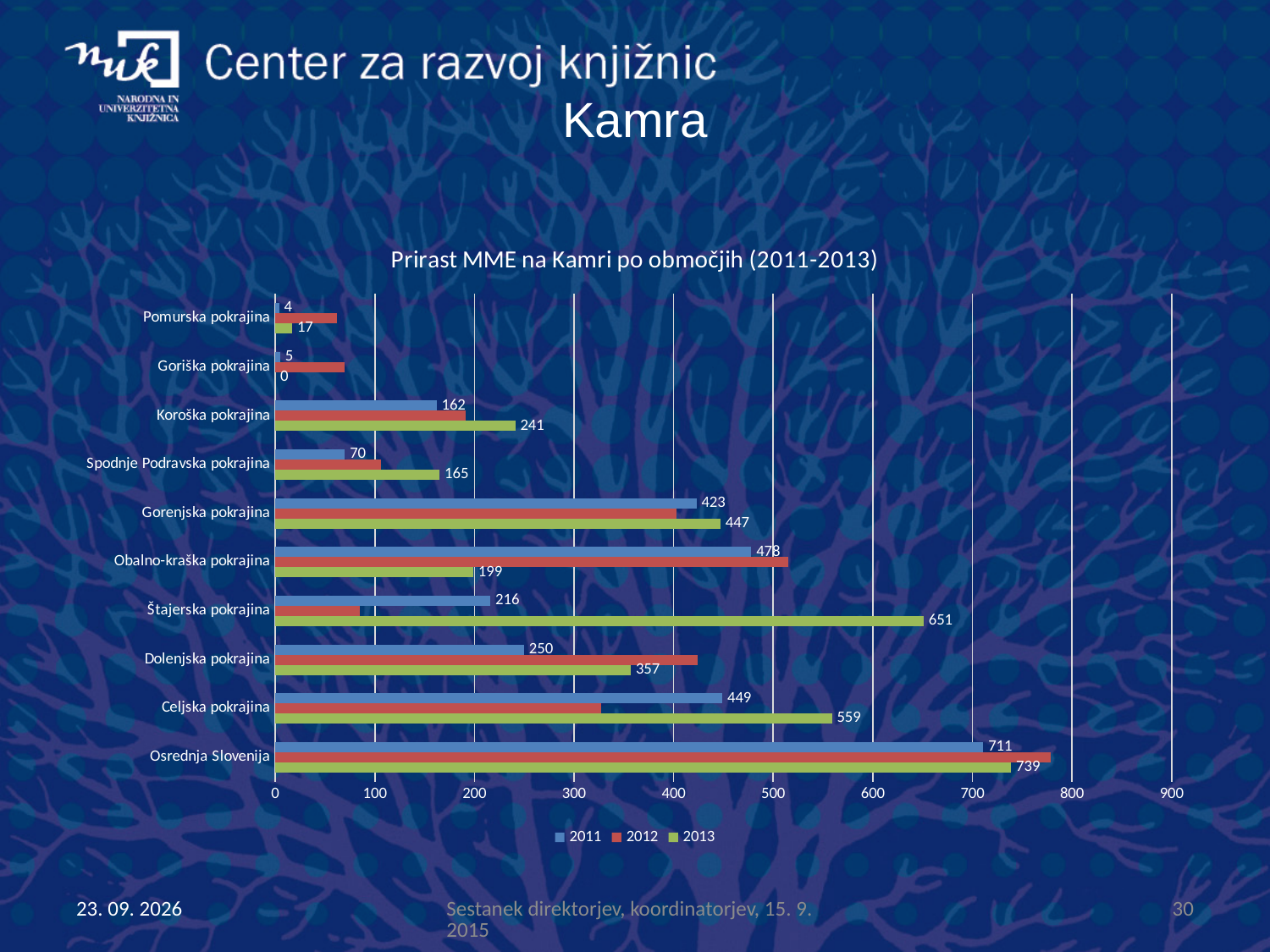
Is the 2012 value for Osrednja Slovenija greater or less than 700? greater What is the 2011 value for Osrednja Slovenija? 711 What is the difference between the 2013 and 2011 values for Osrednja Slovenija? 28 What is the 2013 value for Štajerska pokrajina? 651 Which is larger for Obalno-kraška pokrajina: the 2011 value or the 2013 value? 2011 Which region has the lowest 2013 value? Goriška pokrajina Is the 2012 value for Štajerska pokrajina greater or less than 100? less How many regions are shown on the chart? 10 What type of chart is shown? Bar chart How many series does the legend list? 3 What is the 2013 value for Goriška pokrajina? 0 Which region has the highest 2011 value? Osrednja Slovenija